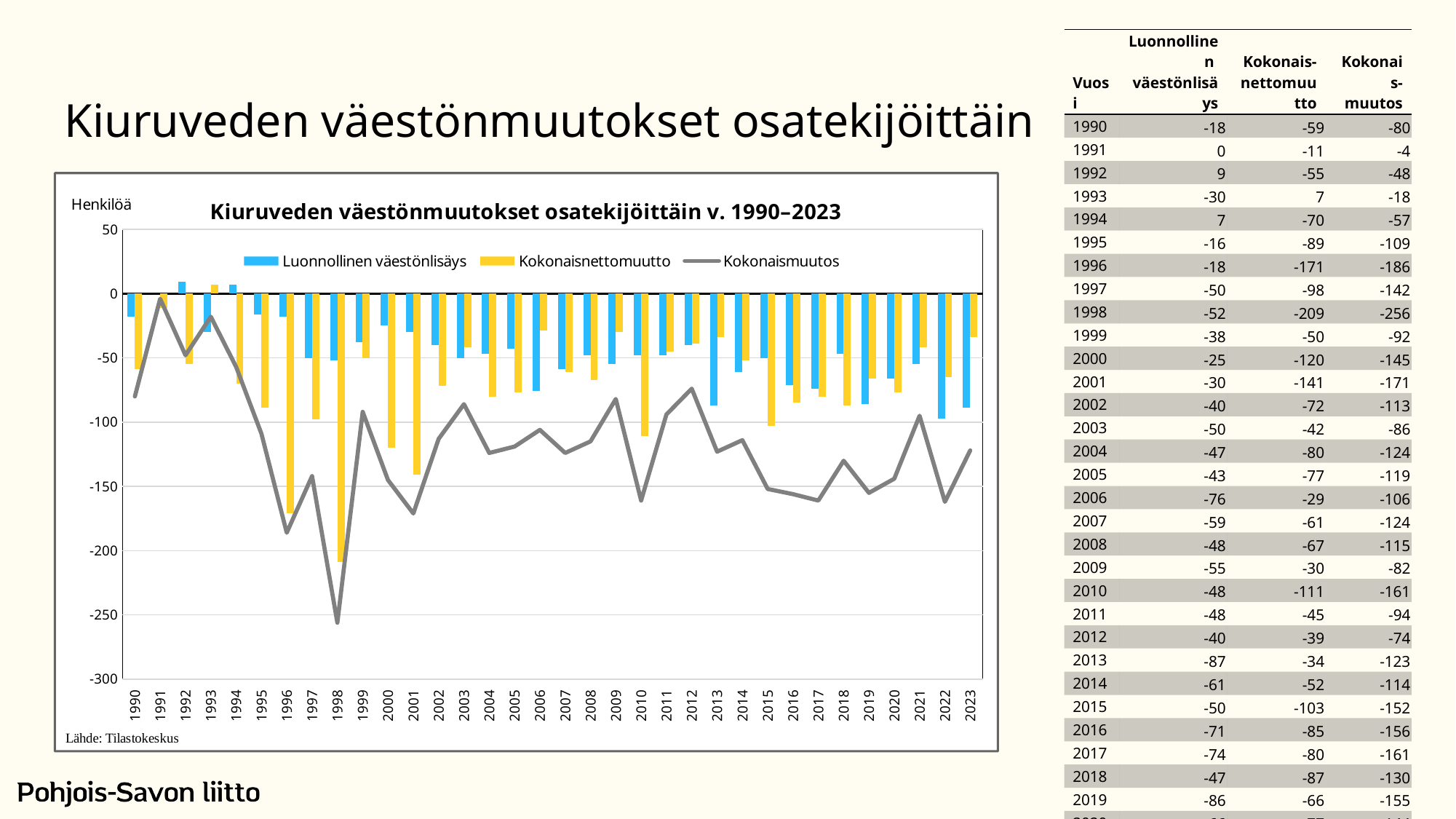
How many series does the chart legend list? 3 What is the value of Luonnollinen väestönlisäys in 2013? -87 Which year has the larger Kokonaismuutos, 1995 or 2000? 1995 Which series is drawn as a grey line in the chart? Kokonaismuutos What is the difference between Kokonaismuutos in 1996 and in 1998? 70 In which year is Kokonaismuutos at its lowest? 1998 What is the title of the chart? Kiuruveden väestönmuutokset osatekijöittäin v. 1990–2023 What kind of chart is shown on the slide? Combined bar and line chart What is the value of Kokonaisnettomuutto in 1998? -209 How many years are plotted along the x axis of the chart? 34 Is the value of Kokonaismuutos for 2023 greater or less than -100? less In which year is Kokonaismuutos at its highest? 1991